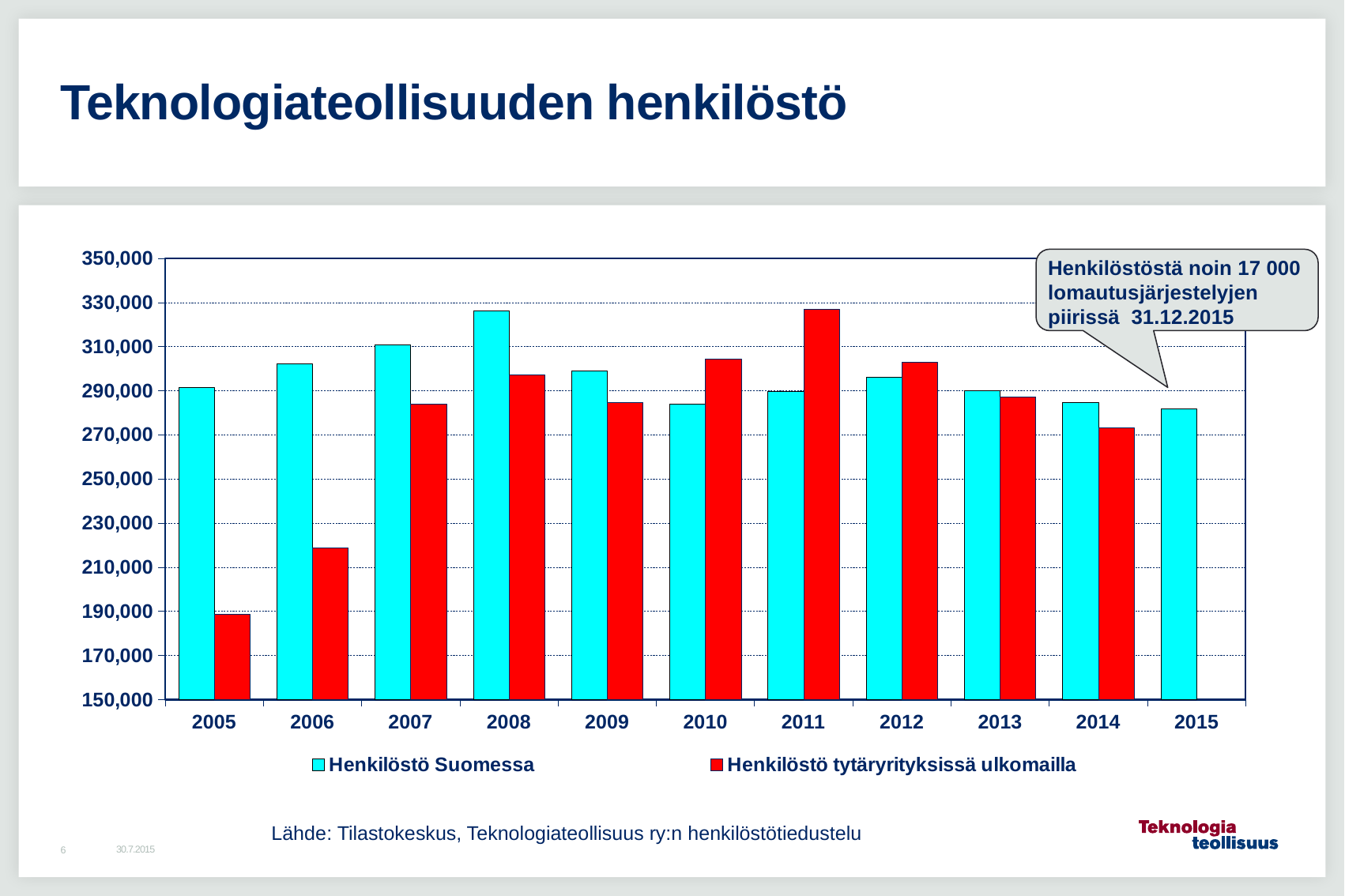
Is the value for Henkilöstö tytäryrityksissä ulkomailla in 2006 greater or less than 210,000? greater In which year is Henkilöstö tytäryrityksissä ulkomailla highest? 2011 In 2005, which series has the larger value: Henkilöstö Suomessa or Henkilöstö tytäryrityksissä ulkomailla? Henkilöstö Suomessa Does Henkilöstö tytäryrityksissä ulkomailla rise or fall from 2005 to 2008? rise In which year is Henkilöstö Suomessa highest? 2008 In which year is Henkilöstö tytäryrityksissä ulkomailla lowest? 2005 What kind of chart is shown on the slide? bar chart In 2011, which series has the larger value: Henkilöstö Suomessa or Henkilöstö tytäryrityksissä ulkomailla? Henkilöstö tytäryrityksissä ulkomailla How many series does the legend list? 2 How many years are shown on the x axis? 11 Is the value for Henkilöstö Suomessa in 2015 greater or less than 290,000? less Is the value for Henkilöstö tytäryrityksissä ulkomailla in 2014 greater or less than 290,000? less